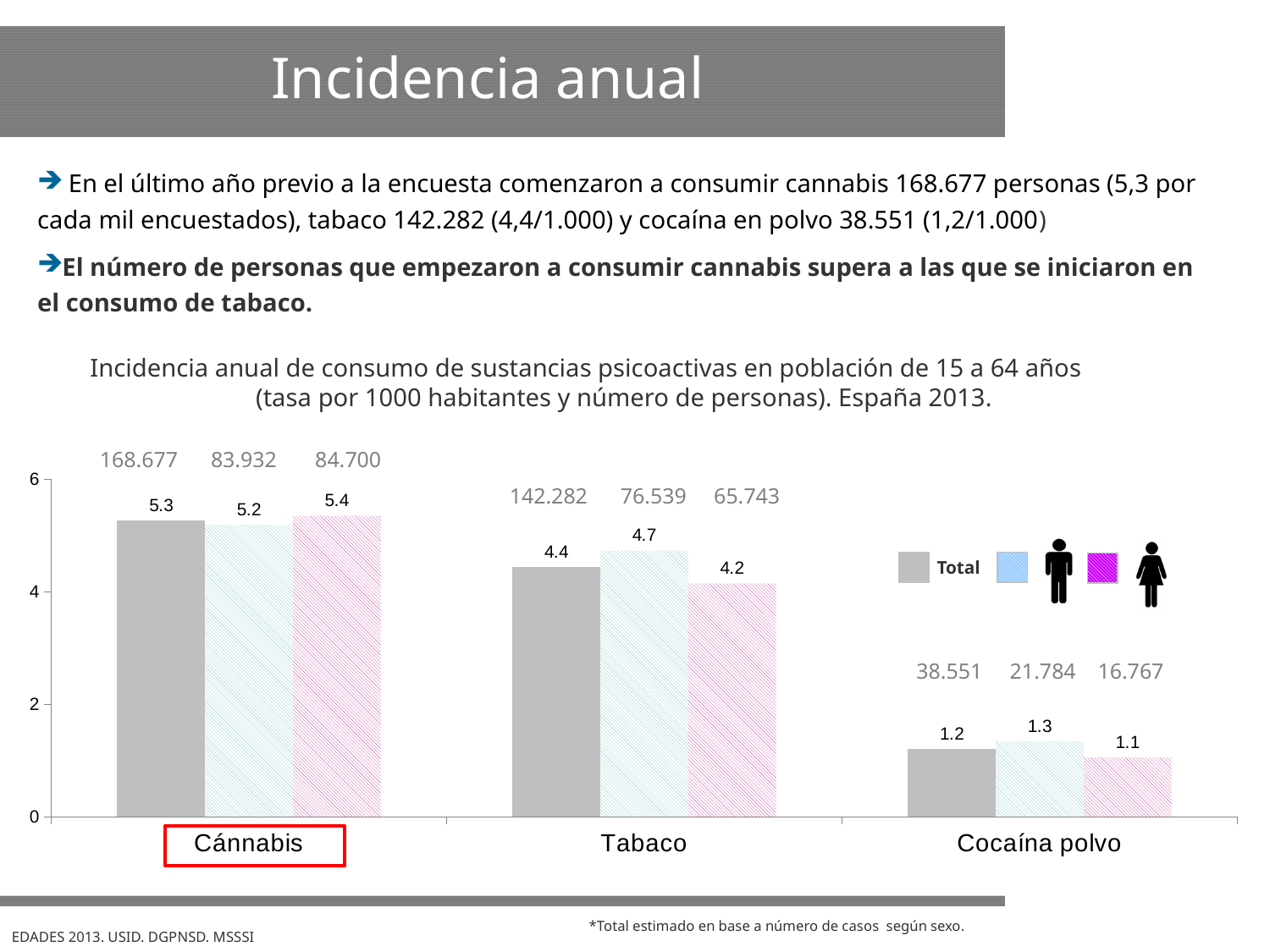
What is the rate for women (pink bar) for Tabaco? 4.2 Which substance has the lowest Total rate? Cocaína polvo What is the Total rate (per 1000) for Cocaína polvo? 1.2 Which substance has the highest Total rate? Cánnabis What is the Total rate (per 1000) for Tabaco? 4.4 For Tabaco, which is larger: the rate for men or the rate for women? men (4.7) What is the Total rate (per 1000) for Cánnabis? 5.3 How many series does the legend list? 3 How many substance categories are shown on the x axis? 3 What is the rate for men (blue bar) for Cocaína polvo? 1.3 What is the difference between the Total rate for Cánnabis and the Total rate for Tabaco? 0.9 What kind of chart is shown on the slide? bar chart